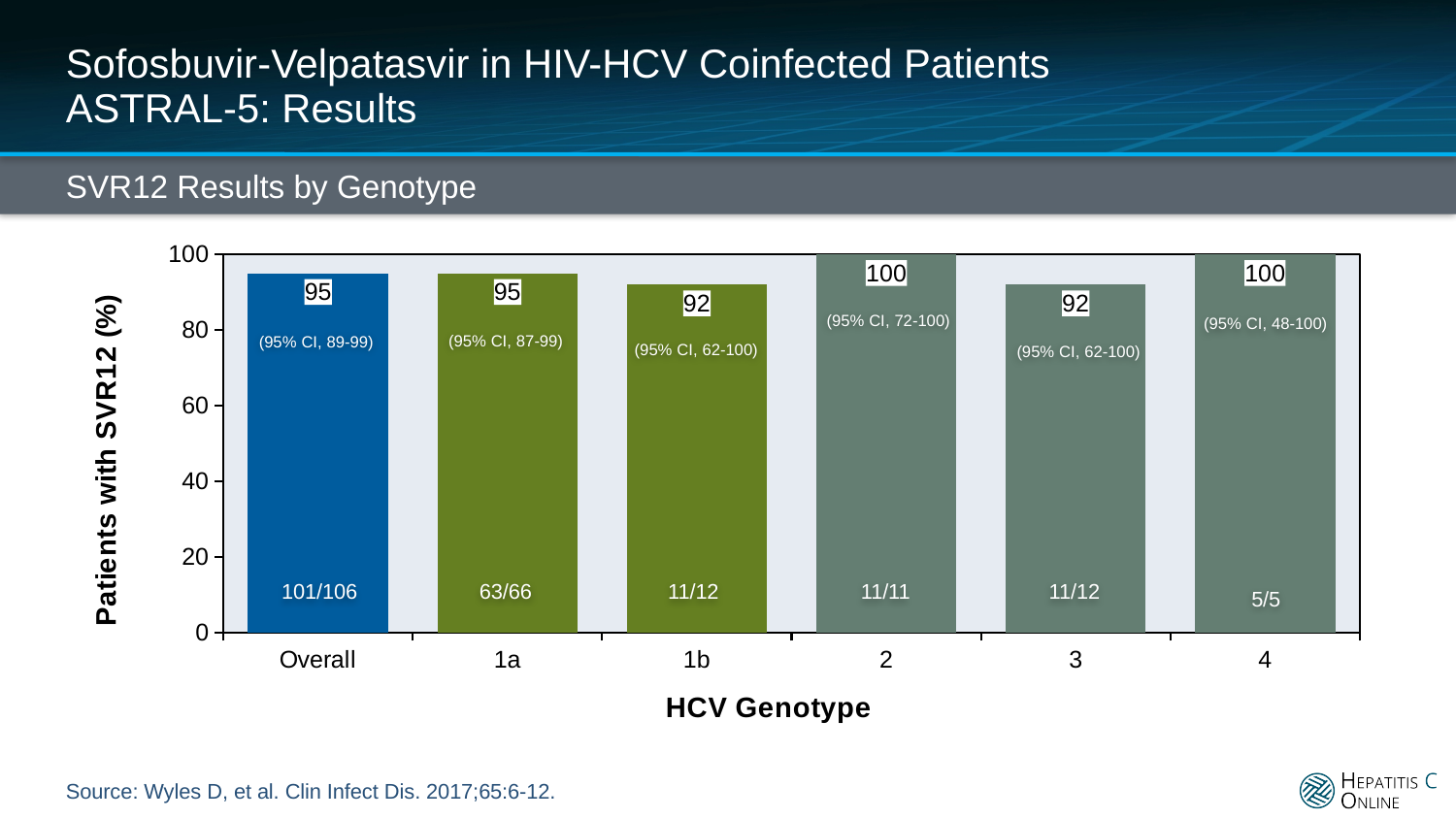
How many patients achieved SVR12 out of the total in genotype 1a, as shown on the bar? 63/66 What is the SVR12 rate for the Overall group? 95 How many categories are shown on the x axis? 6 What is the difference between the SVR12 rate for genotype 2 and genotype 3? 8 What is the SVR12 rate for HCV genotype 1b? 92 Which genotype categories have the lowest SVR12 rate? 1b and 3 What is the SVR12 rate for HCV genotype 2? 100 What kind of chart is shown on the slide? Bar chart Which has a higher SVR12 rate, genotype 1a or genotype 1b? 1a What is the label of the y axis? Patients with SVR12 (%) What is the label of the x axis? HCV Genotype What is the 95% confidence interval shown for genotype 4? 95% CI, 48-100